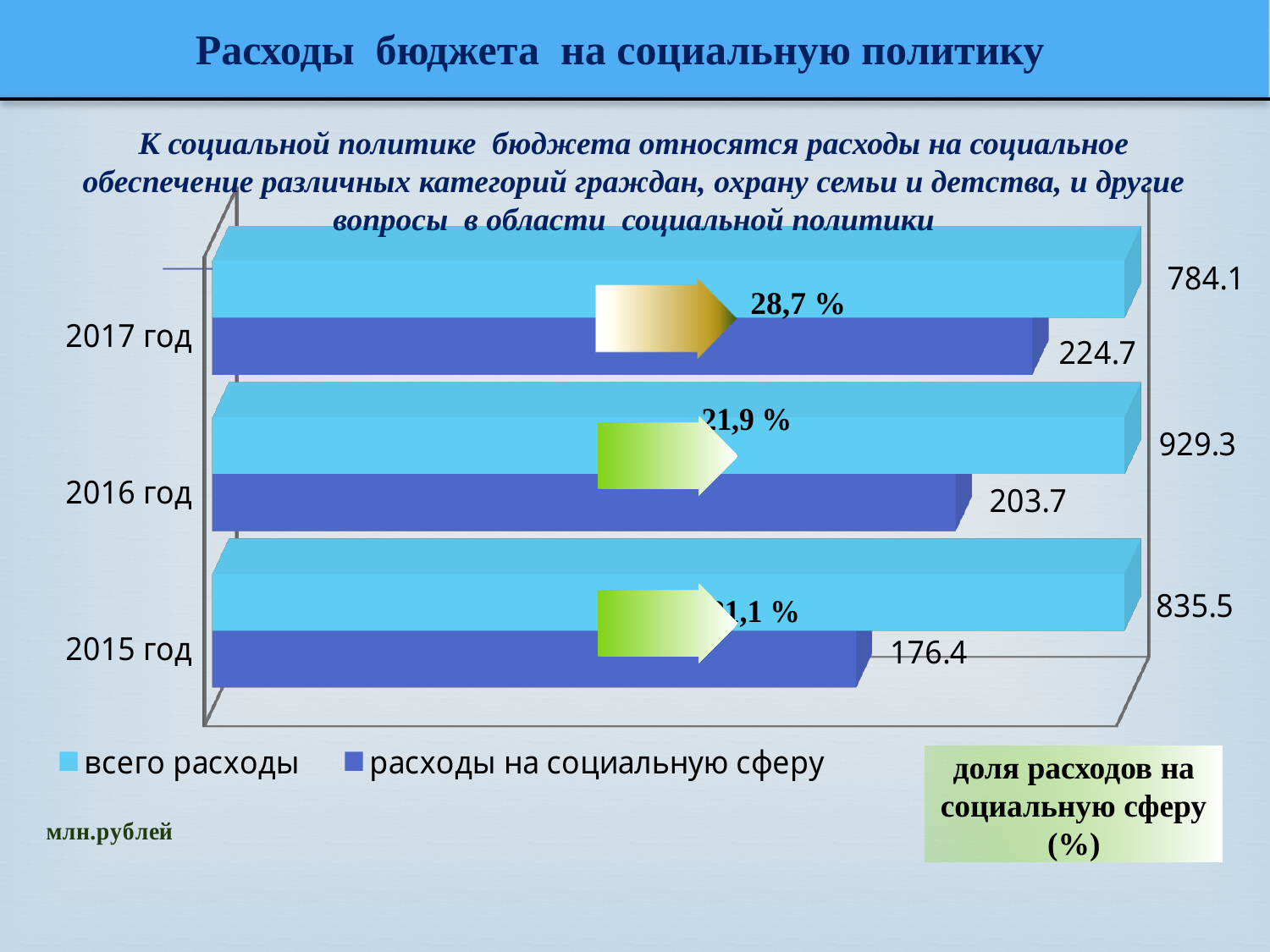
How many years are shown on the chart? 3 What is the difference between "всего расходы" for 2016 год and 2017 год? 145.2 How many series does the legend list? 2 What is the value of "всего расходы" for 2017 год? 784.1 Which year has the highest value for "всего расходы"? 2016 год What kind of chart is shown on the slide? bar chart Which year has the lowest value for "расходы на социальную сферу"? 2015 год What share of expenses on the social sphere (%) is shown for 2017 год? 28,7 % Which is larger: "расходы на социальную сферу" for 2016 год or for 2017 год? 2017 год What is the value of "расходы на социальную сферу" for 2015 год? 176.4 What is the value of "расходы на социальную сферу" for 2017 год? 224.7 What is the value of "всего расходы" for 2016 год? 929.3